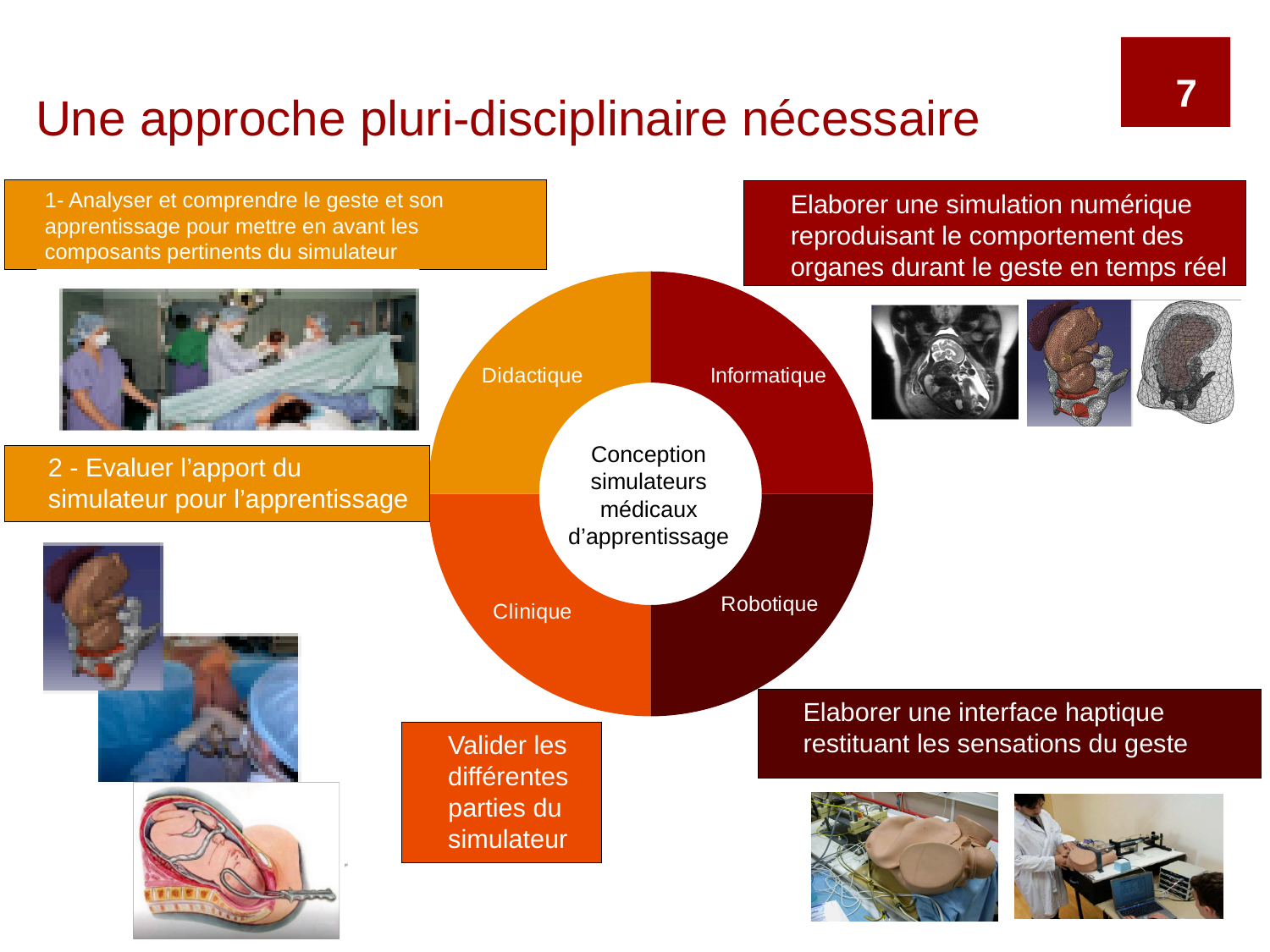
How many segments does the donut chart have? 4 Which segment of the donut chart is located at the bottom left? Clinique Which segment of the donut chart is coloured light orange (top left)? Didactique Which segment of the donut chart is located at the top right? Informatique Which segment of the donut chart is located at the bottom right? Robotique What kind of chart is shown in the centre of the slide? Donut chart What text appears in the centre of the donut chart? Conception simulateurs médicaux d'apprentissage Which four disciplines are labelled on the segments of the donut chart? Didactique, Informatique, Clinique, Robotique